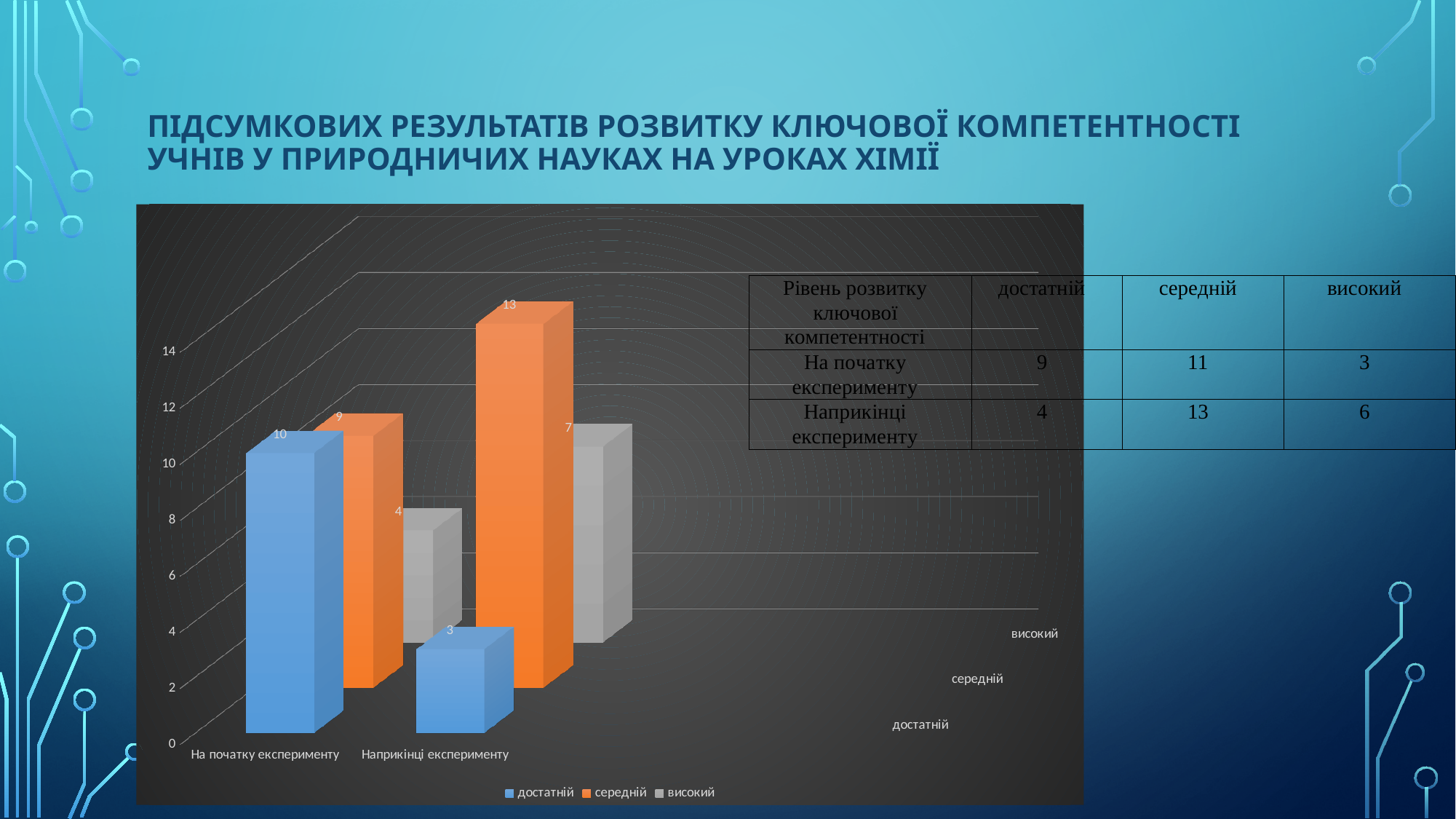
What is the value of the високий series for На початку експерименту in the chart? 4 Which series has the lowest value for На початку експерименту in the chart? високий How many series does the chart legend list? 3 What is the value of the середній series for Наприкінці експерименту in the chart? 13 How many categories are shown on the x axis of the chart? 2 What kind of chart is shown on the slide? bar chart What is the difference between the середній values for Наприкінці експерименту and На початку експерименту in the chart? 4 What is the value of the достатній series for На початку експерименту in the chart? 10 Which series has the highest value for Наприкінці експерименту in the chart? середній Which is larger in the chart: the високий value for На початку експерименту or for Наприкінці експерименту? Наприкінці експерименту Which series is shown in orange in the chart legend? середній What is the value of the достатній series for Наприкінці експерименту in the chart? 3